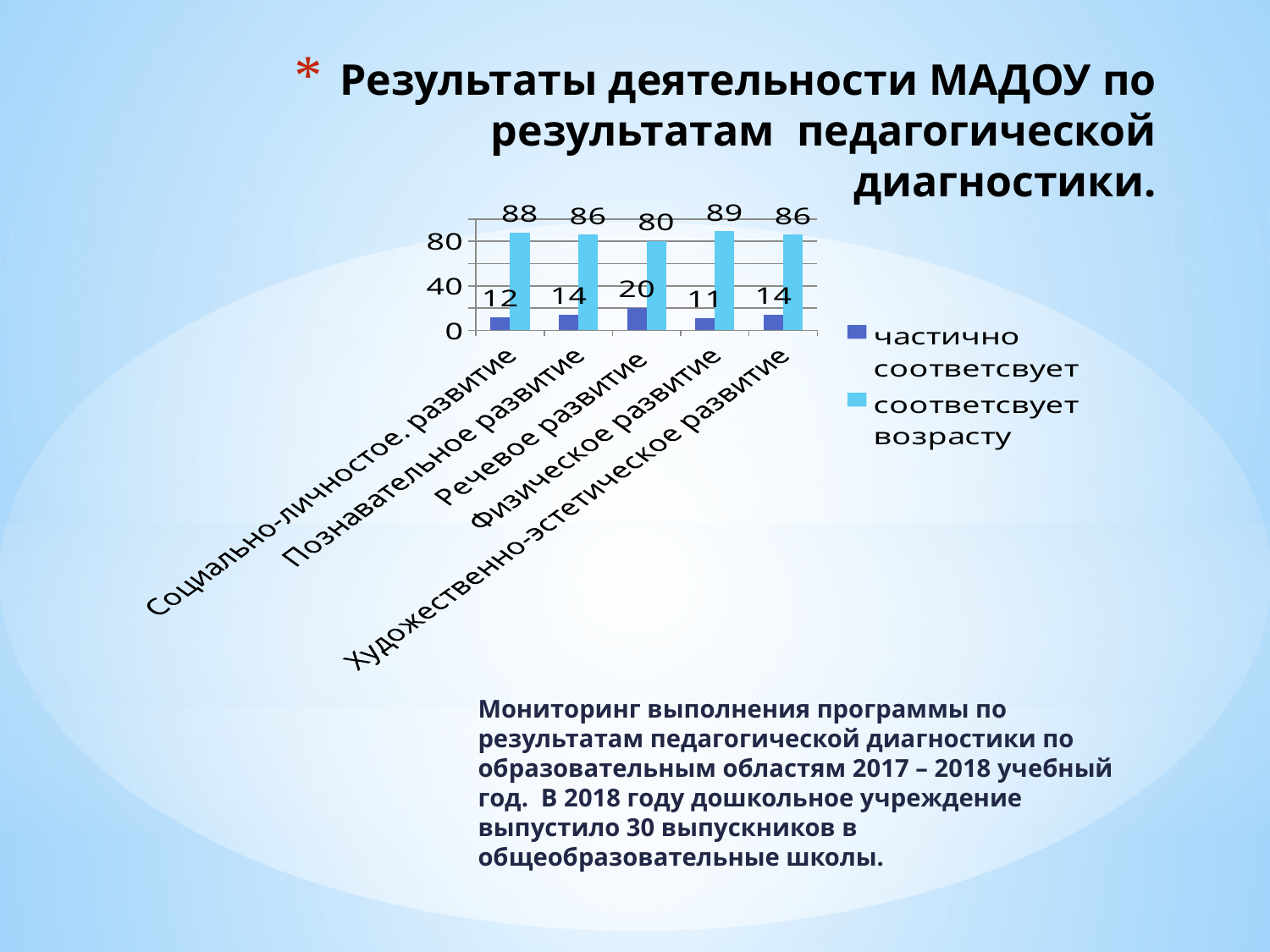
Which category has the lowest value for 'соответсвует возрасту'? Речевое развитие How many categories are shown on the x axis of the chart? 5 Which category has the highest value for 'частично соответсвует'? Речевое развитие What is the value of 'соответсвует возрасту' for Речевое развитие? 80 What is the difference between the 'соответсвует возрасту' values for Физическое развитие and Речевое развитие? 9 Which is larger: the 'частично соответсвует' value for Речевое развитие or for Социально-личностое. развитие? Речевое развитие Which series is shown in light blue in the chart legend? соответсвует возрасту How many series does the chart legend list? 2 What type of chart is shown on the slide? bar chart What is the total of the two series for Познавательное развитие? 100 What is the value of 'частично соответсвует' for Физическое развитие? 11 What is the value of 'соответсвует возрасту' for Физическое развитие? 89